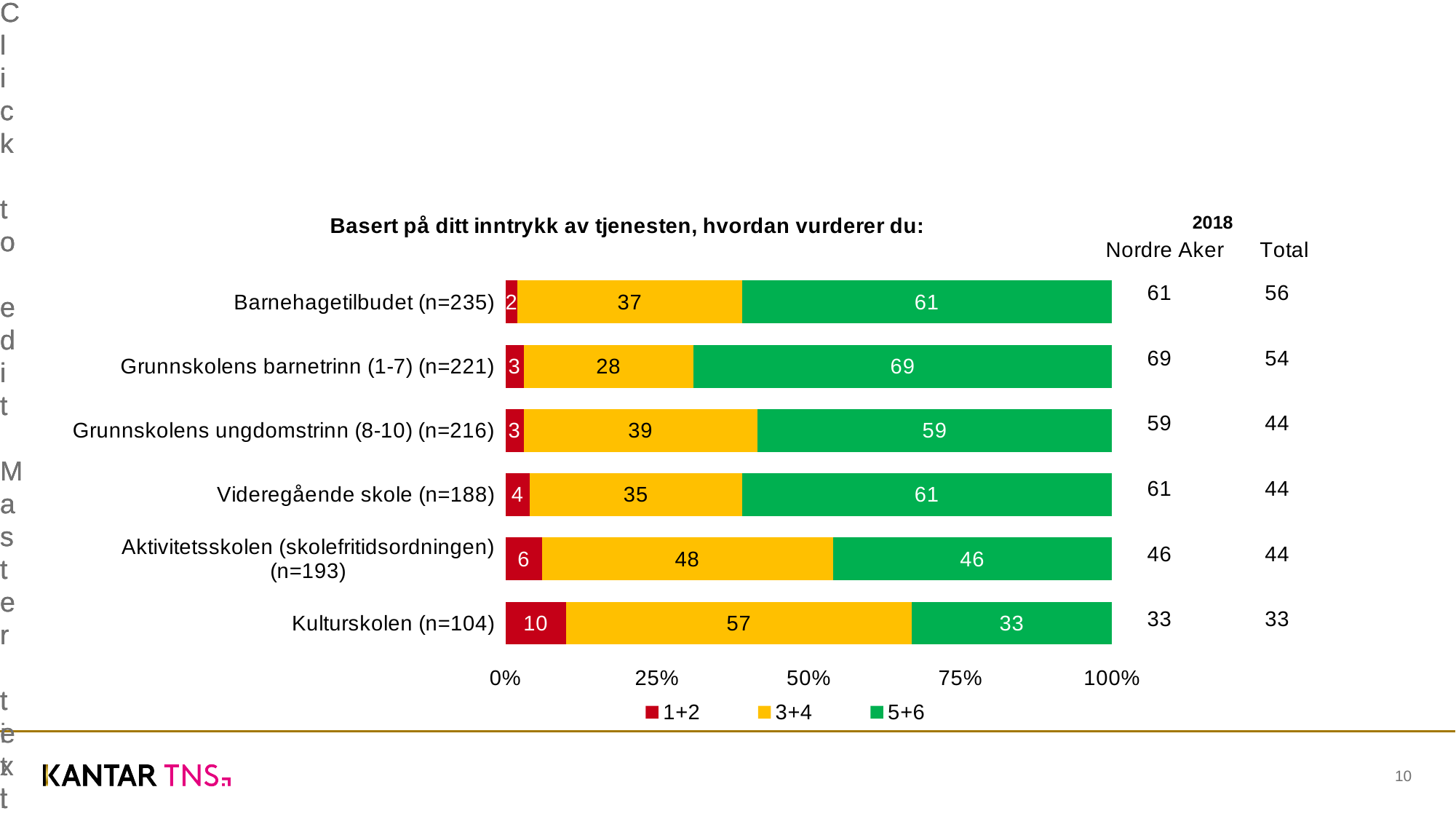
What is the difference between the 5+6 values for Barnehagetilbudet (n=235) and Kulturskolen (n=104)? 28 What is the Total value shown for Grunnskolens ungdomstrinn (8-10) (n=216) in the 2018 table? 44 How many series does the legend list? 3 What is the 5+6 value for Grunnskolens barnetrinn (1-7) (n=221)? 69 How many categories are plotted in the chart? 6 What is the 1+2 value for Aktivitetsskolen (skolefritidsordningen) (n=193)? 6 What kind of chart is shown on the slide? Stacked bar chart Which category has the highest 1+2 value? Kulturskolen (n=104) What is the 3+4 value for Kulturskolen (n=104)? 57 Which category has the highest 5+6 value? Grunnskolens barnetrinn (1-7) (n=221) Which category has the lowest 5+6 value? Kulturskolen (n=104) Is the 3+4 value larger for Aktivitetsskolen (skolefritidsordningen) (n=193) or for Videregående skole (n=188)? Aktivitetsskolen (skolefritidsordningen) (n=193)